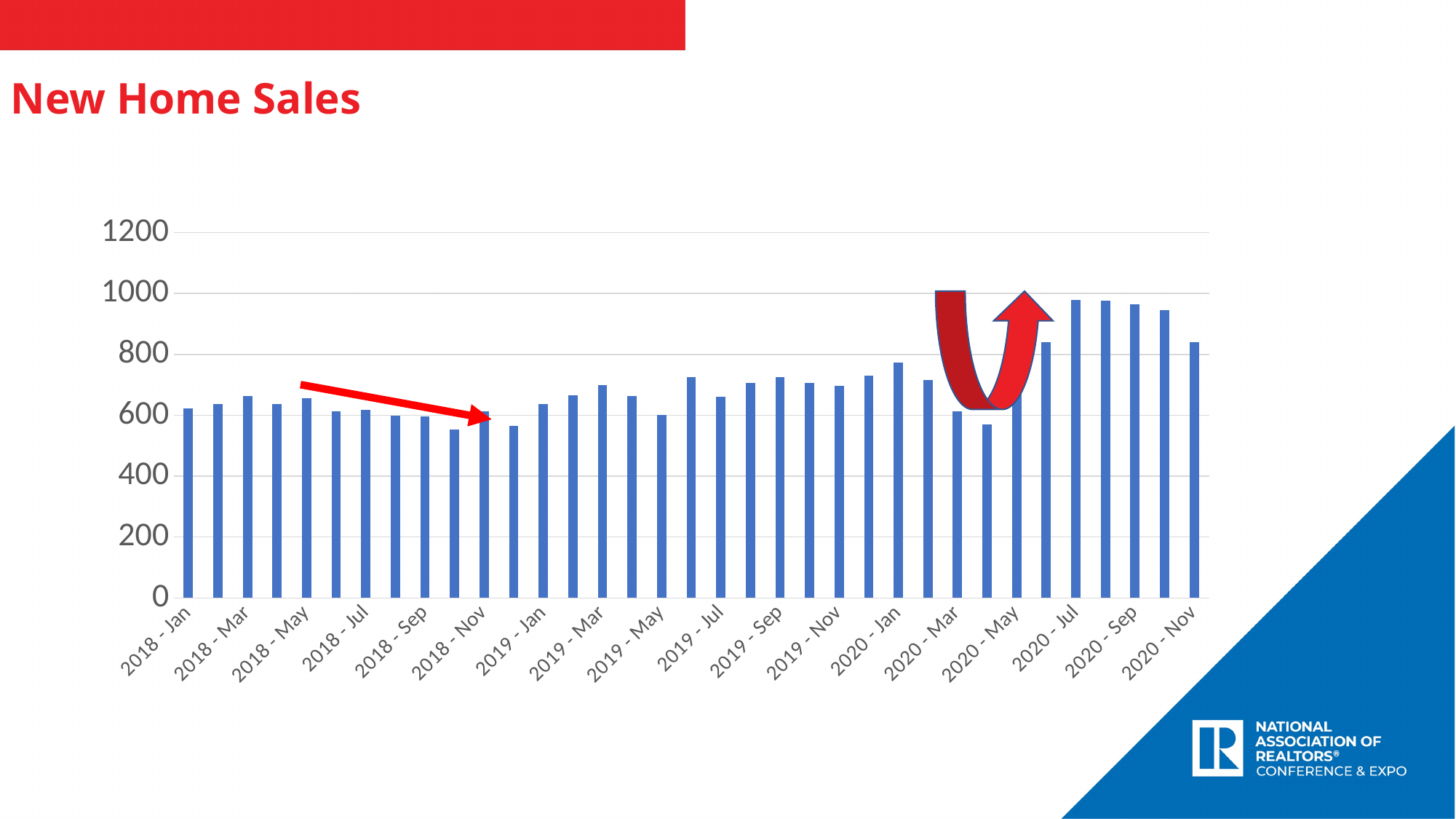
Is the value for 2020 - Nov greater or less than 800? greater What is the first month label shown on the x axis? 2018 - Jan Is the value for 2018 - Jan greater or less than 800? less Is the value for 2020 - Jul greater or less than 800? greater How many monthly bars are plotted in the chart? 35 What is the title of the chart? New Home Sales Do the values rise or fall from 2020 - May to 2020 - Jul? rise Which is larger, the value for 2020 - Sep or the value for 2020 - Nov? 2020 - Sep What kind of chart is shown on the slide? bar chart Do the values rise or fall from 2020 - Jul to 2020 - Nov? fall Which is larger, the value for 2020 - Jul or the value for 2018 - Jan? 2020 - Jul